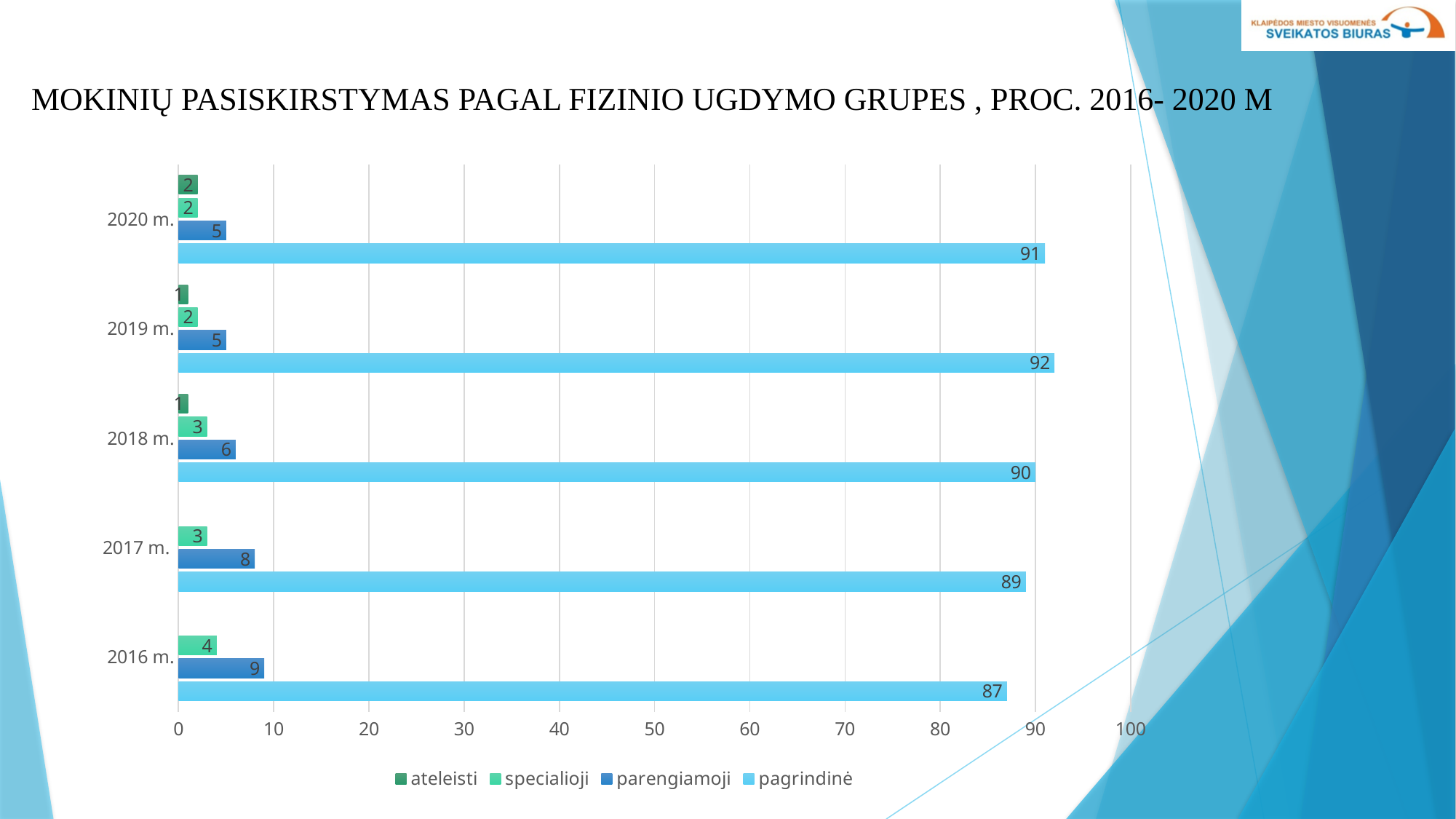
What is the value for parengiamoji in 2016 m.? 9 In which year is the pagrindinė value lowest? 2016 m. Does the parengiamoji value rise or fall from 2016 m. to 2020 m.? fall What is the value for ateleisti in 2020 m.? 2 What type of chart is shown on the slide? bar chart What is the difference between the pagrindinė values for 2020 m. and 2016 m.? 4 What is the value for pagrindinė in 2019 m.? 92 How many series does the legend list? 4 How many year categories are shown on the chart? 5 What is the value for specialioji in 2018 m.? 3 Which is larger, the parengiamoji value in 2017 m. or in 2018 m.? 2017 m. In which year is the pagrindinė value highest? 2019 m.